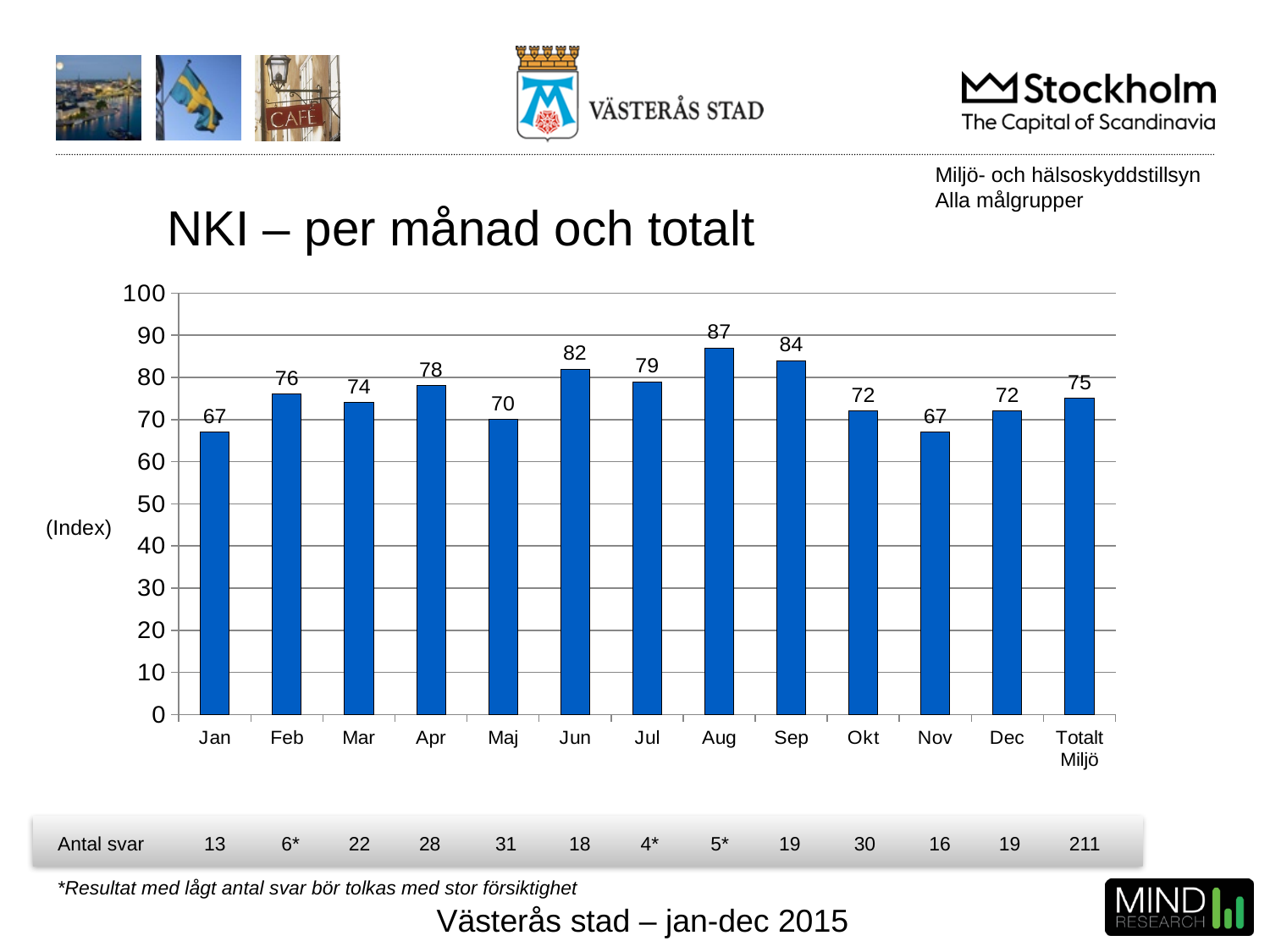
What is the title of the chart? NKI – per månad och totalt What is the difference between the NKI values for Aug and Nov? 20 What is the NKI value for Maj? 70 Is the NKI value for Apr greater or less than 70? greater What kind of chart is shown on the slide? bar chart What is the NKI value for Aug? 87 What is the NKI value for Totalt Miljö? 75 Do the NKI values rise or fall from Sep to Nov? fall Which has a higher NKI value, Jun or Sep? Sep What is the lowest NKI value shown in the chart? 67 Which month has the highest NKI value? Aug How many bars are shown in the chart? 13